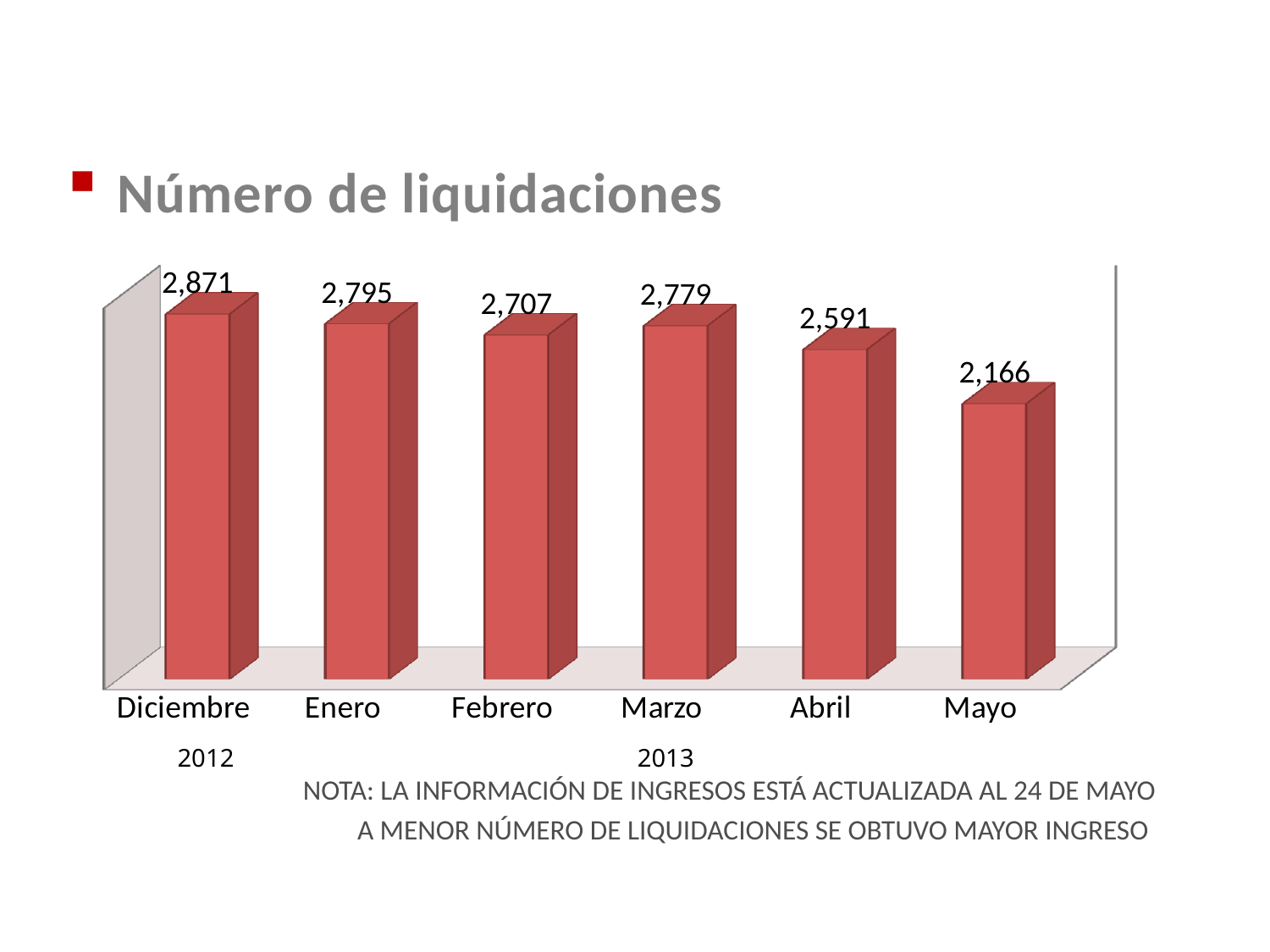
How many months are shown in the chart? 6 What is the number of liquidaciones for Diciembre? 2,871 Which month has the highest number of liquidaciones? Diciembre What kind of chart is shown on the slide? Bar chart Which month has the lowest number of liquidaciones? Mayo What is the value shown for Abril? 2,591 What is the value shown for Mayo? 2,166 What is the title of the chart? Número de liquidaciones What is the difference between the values for Enero and Febrero? 88 What is the value shown for Febrero? 2,707 Which is larger, the value for Marzo or the value for Abril? Marzo What is the difference between the values for Diciembre and Mayo? 705